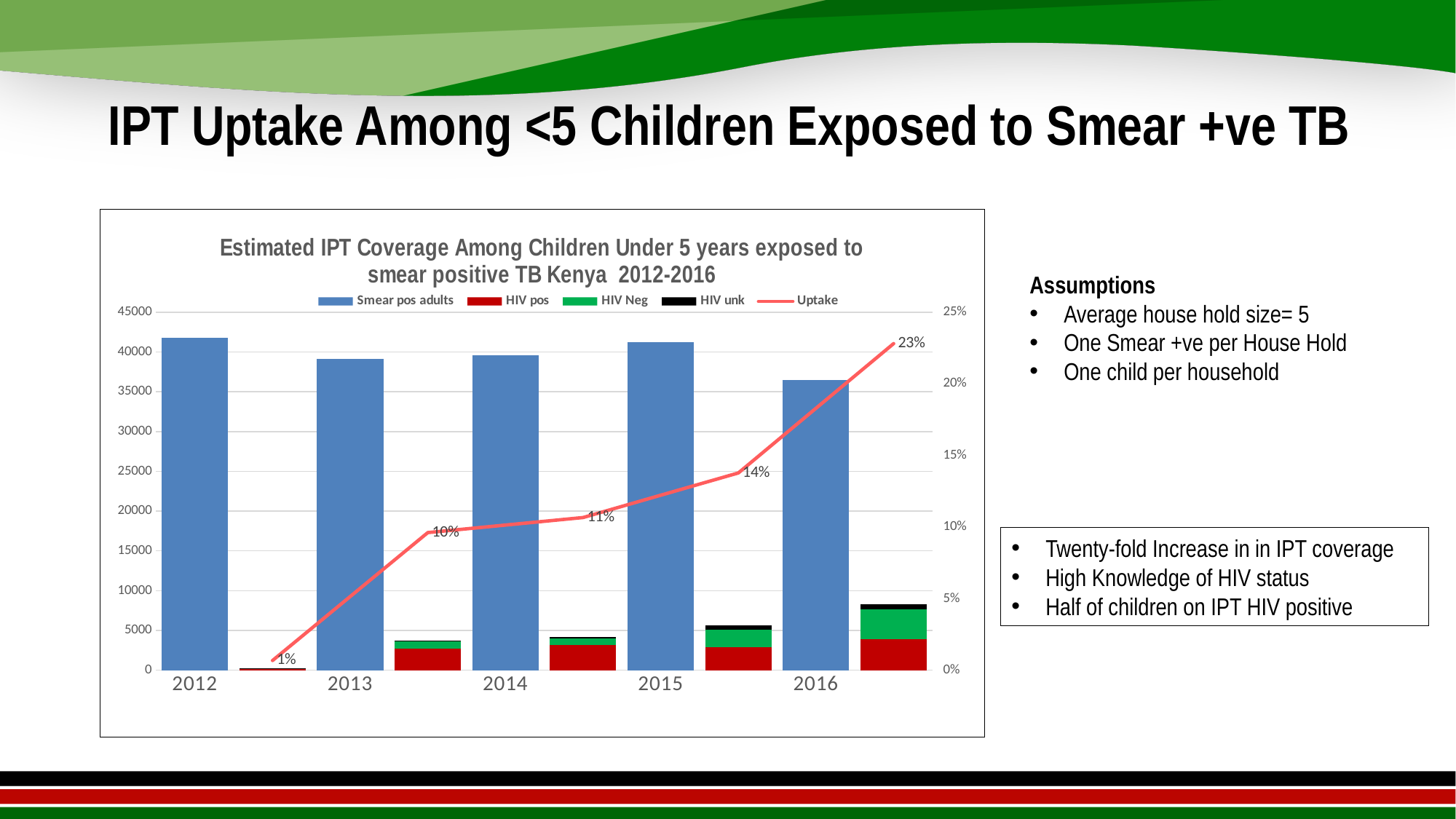
Does the Uptake line rise or fall from 2012 to 2016? rise How many series does the legend list? 5 Which year has the larger Smear pos adults value, 2012 or 2016? 2012 What is the Uptake value for 2016? 23% In which year is the Uptake highest? 2016 What is the Uptake value for 2012? 1% What is the Uptake value for 2013? 10% In which year is the Uptake lowest? 2012 Is the value for Smear pos adults in 2016 greater or less than 40000? less How many years are shown on the x axis? 5 What is the Uptake value for 2015? 14% By how many percentage points did Uptake increase from 2012 to 2016? 22%